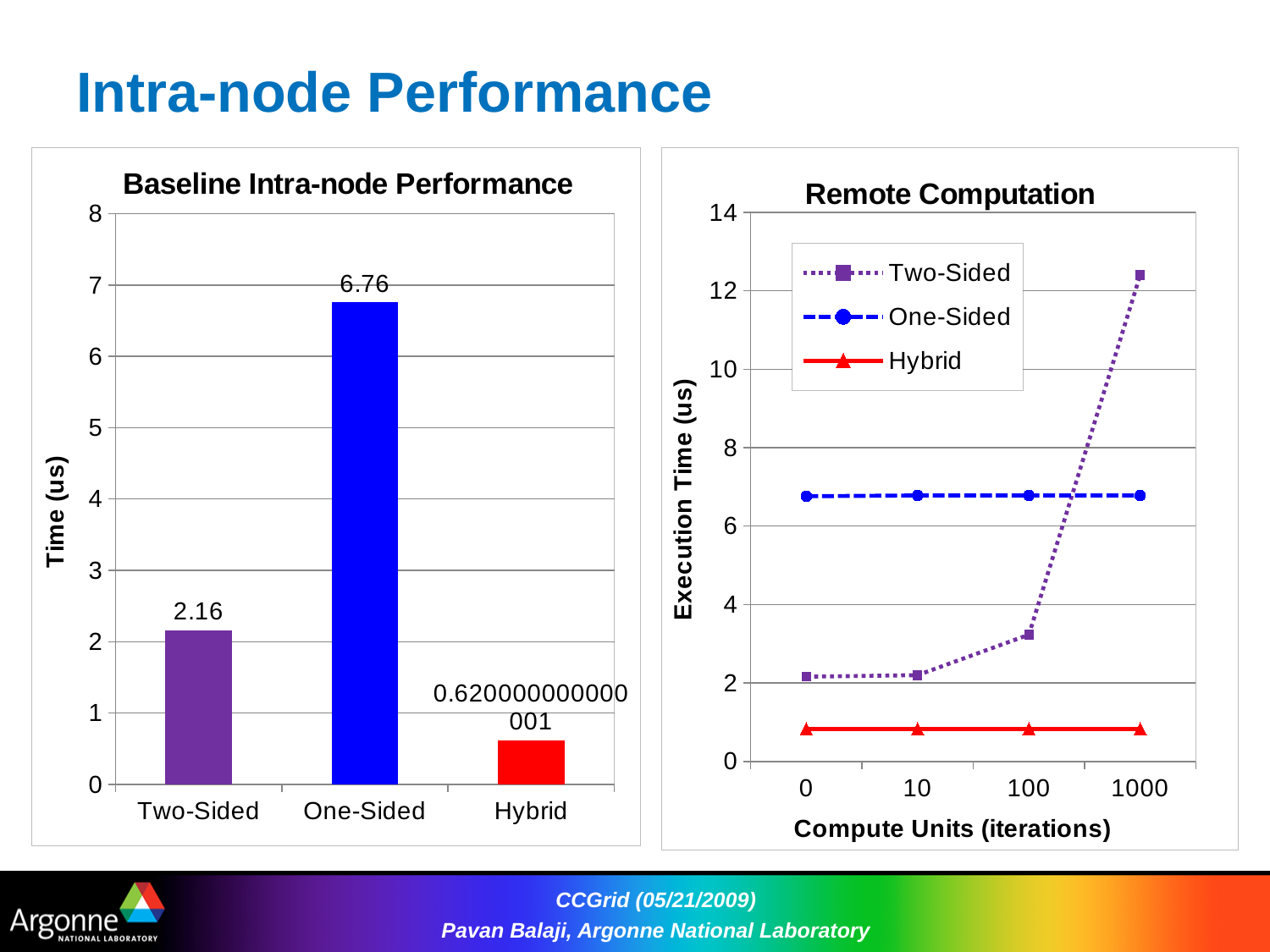
In the Baseline Intra-node Performance chart, which category has the lowest time? Hybrid In the Remote Computation chart, is the Two-Sided value at 1000 compute units greater or less than 10? greater In the Baseline Intra-node Performance chart, which category has the highest time? One-Sided In the Baseline Intra-node Performance chart, how many categories are shown? 3 In the Remote Computation chart, is the Hybrid value at 100 compute units greater or less than 2? less In the Baseline Intra-node Performance chart, what is the difference between the One-Sided and Two-Sided values? 4.60 In the Baseline Intra-node Performance chart, what is the value for Two-Sided? 2.16 What kind of chart is the Baseline Intra-node Performance chart? bar chart In the Remote Computation chart, how many series does the legend list? 3 In the Baseline Intra-node Performance chart, what is the value for One-Sided? 6.76 What is the x-axis label of the Remote Computation chart? Compute Units (iterations) In the Remote Computation chart, does the Two-Sided series rise or fall as compute units increase? rise